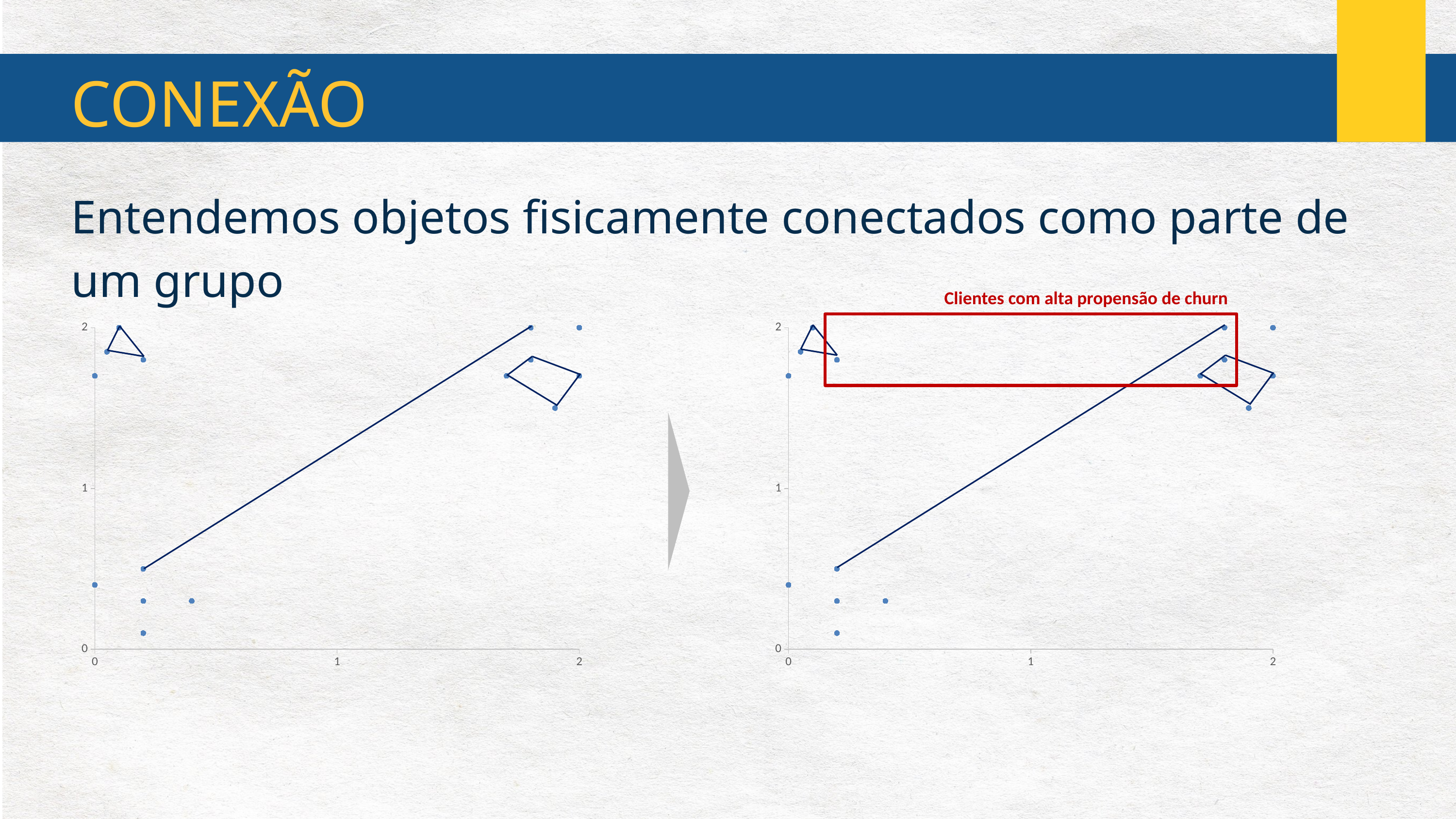
In the right chart, is the vertical value of the points inside the red box greater or less than 1? greater How many points are connected to form the quadrilateral in the top-right area of the left chart? 4 How many data points are plotted in the left chart? 15 How many charts are shown on the slide? 2 What is the highest tick value shown on the horizontal axis of the left chart? 2 In the left chart, is the vertical value of the lowest plotted point greater or less than 1? less What kind of chart is shown on the left side of the slide? scatter chart What is the red annotation text above the right chart? Clientes com alta propensão de churn